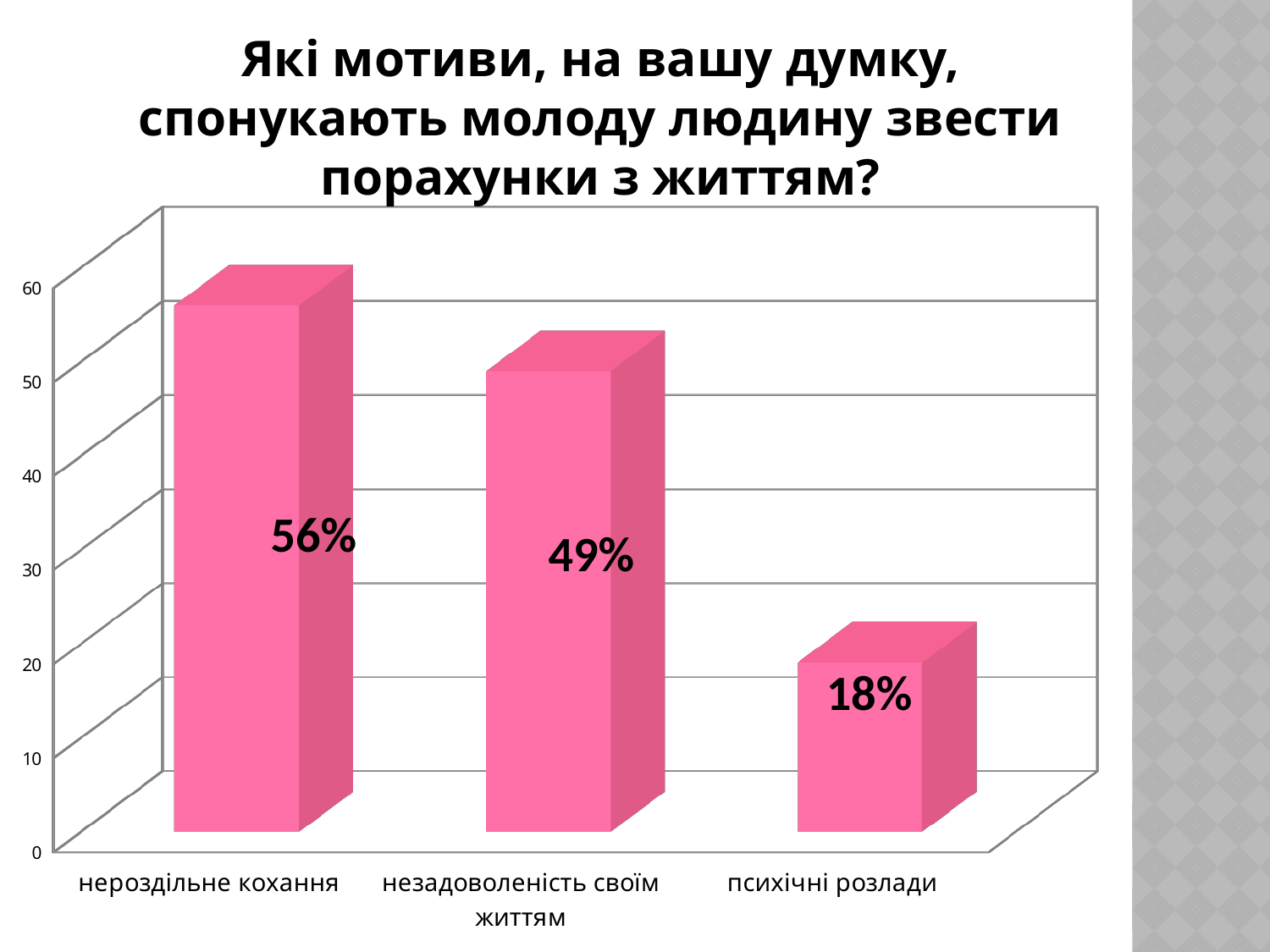
What is the value for нероздільне кохання? 56% Do the values rise or fall from left to right along the x axis? fall What is the value for психічні розлади? 18% Is the value for психічні розлади greater or less than 20? less What is the value for незадоволеність своїм життям? 49% Which category has the lowest value? психічні розлади What is the difference between the values for нероздільне кохання and незадоволеність своїм життям? 7% Which category has the highest value? нероздільне кохання What kind of chart is shown on the slide? bar chart What is the difference between the values for незадоволеність своїм життям and психічні розлади? 31% How many categories are shown in the chart? 3 Which is larger, the value for нероздільне кохання or the value for психічні розлади? нероздільне кохання